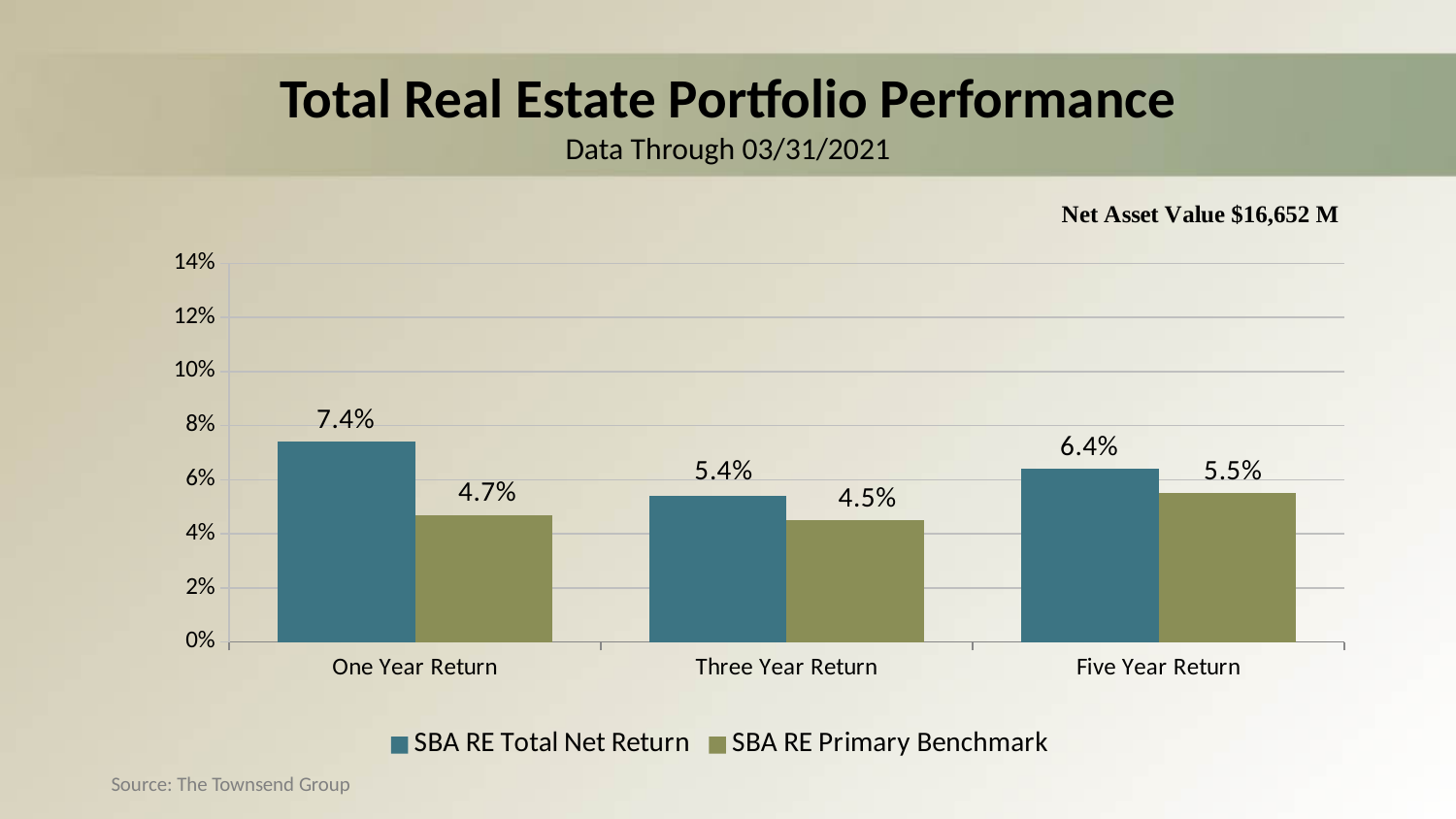
What is the SBA RE Primary Benchmark value for Three Year Return? 4.5% How many return periods are shown on the x axis? 3 For Five Year Return, which is larger: SBA RE Total Net Return or SBA RE Primary Benchmark? SBA RE Total Net Return How many series does the legend list? 2 What is the title of the chart on the slide? Total Real Estate Portfolio Performance Is the SBA RE Total Net Return for Three Year Return greater or less than 6%? less What is the SBA RE Total Net Return for One Year Return? 7.4% Which period has the highest SBA RE Total Net Return? One Year Return What kind of chart is shown on the slide? Bar chart What is the difference between the SBA RE Total Net Return and the SBA RE Primary Benchmark for One Year Return? 2.7% Which period has the lowest SBA RE Primary Benchmark value? Three Year Return What is the SBA RE Primary Benchmark value for Five Year Return? 5.5%